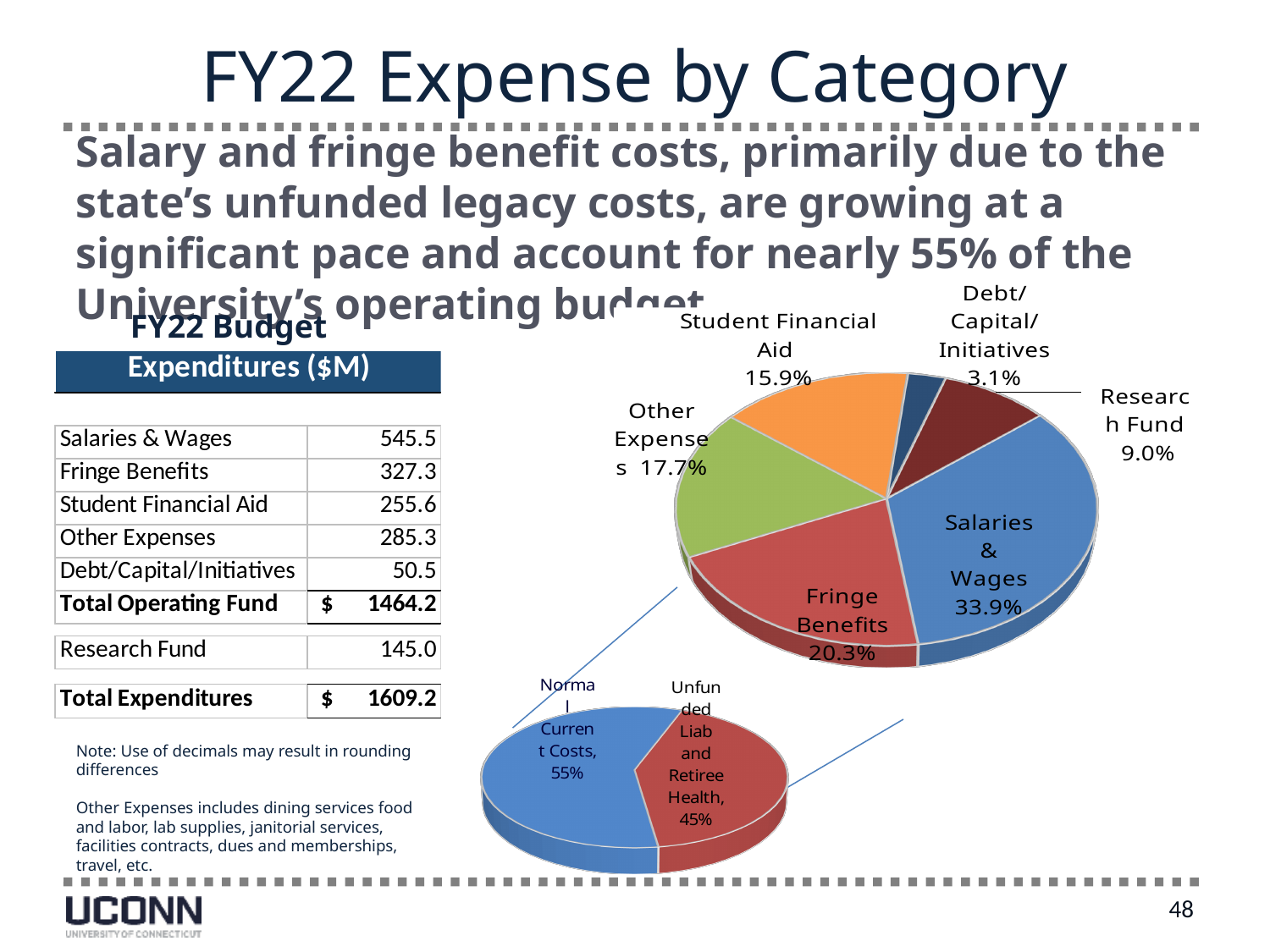
In the large pie chart, which category has the largest share? Salaries & Wages In the small pie chart at the bottom, what share is shown for Unfunded Liab and Retiree Health? 45% In the small pie chart at the bottom, what share is shown for Normal Current Costs? 55% In the large pie chart, what is the difference in percentage points between Salaries & Wages and Fringe Benefits? 13.6 In the large pie chart, what share is shown for Salaries & Wages? 33.9% In the large pie chart, what share is shown for Student Financial Aid? 15.9% In the large pie chart, what share is shown for Fringe Benefits? 20.3% In the large pie chart, what share is shown for Research Fund? 9.0% How many slices does the large pie chart have? 6 In the large pie chart, which category has the smallest share? Debt/Capital/Initiatives In the large pie chart, which is larger: Other Expenses or Student Financial Aid? Other Expenses What kind of chart is the large chart on the right of the slide? Pie chart